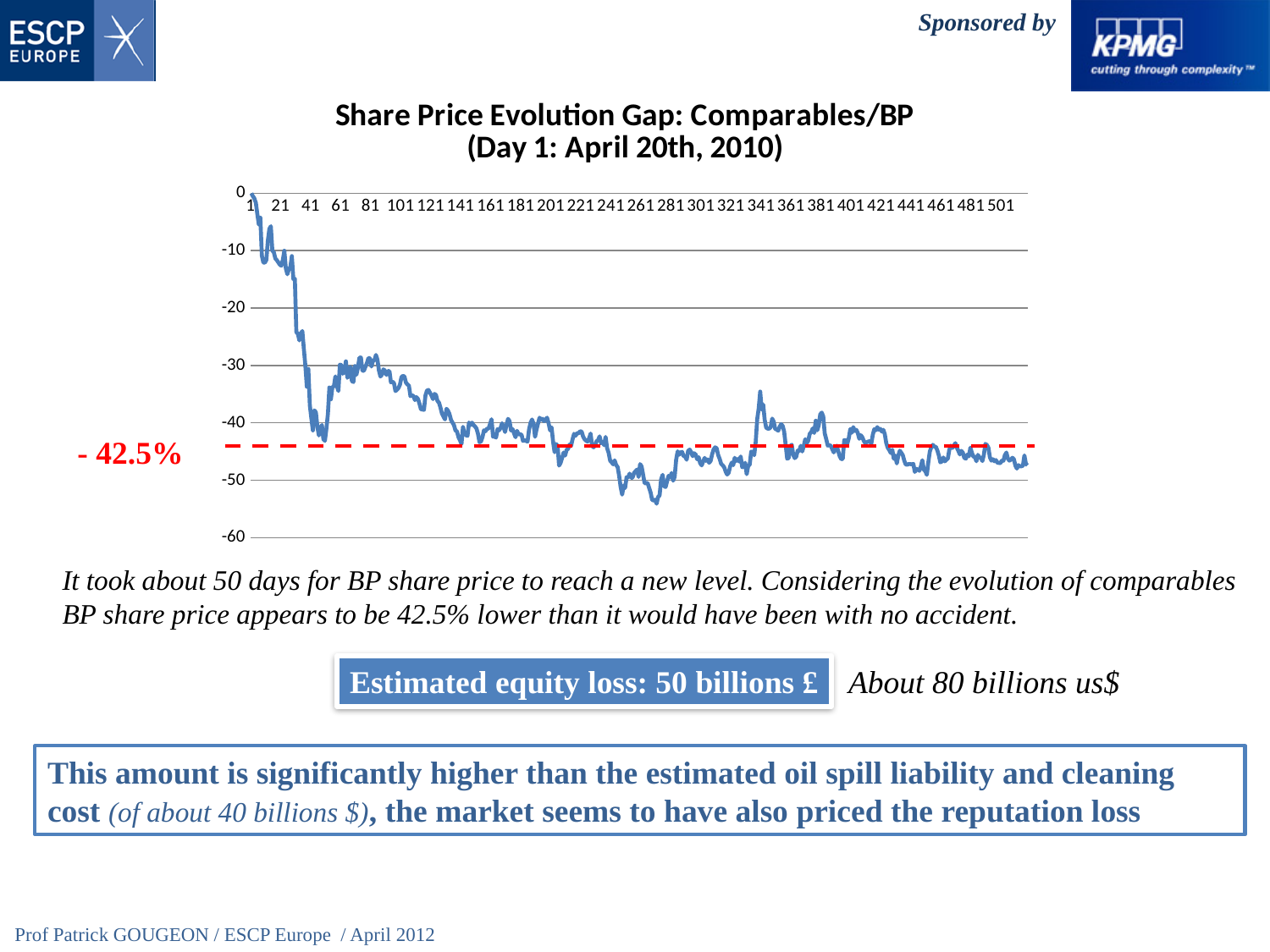
Is the value around day 501 greater or less than -40? less Is the value around day 161 greater or less than -30? less Overall, is the value at the end of the series (around day 501) higher or lower than at the start (day 1)? lower What is the lowest value shown on the vertical axis of the chart? -60 What kind of chart is shown on the slide? line chart Does the line generally rise or fall between day 1 and day 61? fall How many labels are shown along the horizontal axis of the chart? 26 Is the value around day 21 greater or less than -20? greater What is the last label shown on the horizontal axis of the chart? 501 What value is marked by the red dashed horizontal line on the chart? - 42.5% What is the title of the chart? Share Price Evolution Gap: Comparables/BP (Day 1: April 20th, 2010)